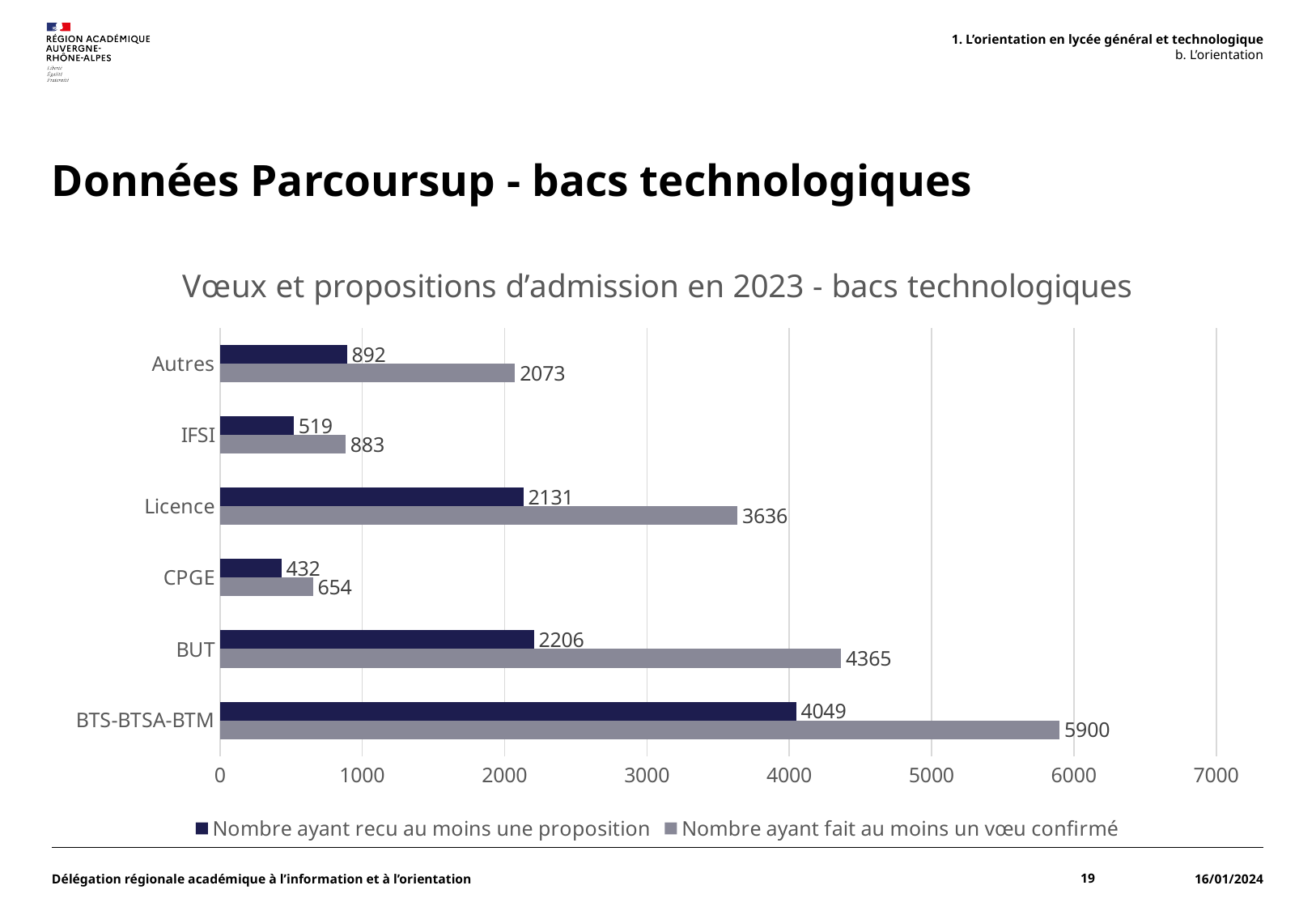
What is the value of "Nombre ayant fait au moins un vœu confirmé" for BTS-BTSA-BTM? 5900 How many series does the legend list? 2 Which is larger: "Nombre ayant fait au moins un vœu confirmé" for Autres or for IFSI? Autres What is the value of "Nombre ayant recu au moins une proposition" for Licence? 2131 Which category has the lowest value for "Nombre ayant fait au moins un vœu confirmé"? CPGE What kind of chart is shown on the slide? Bar chart Which category has the highest value for "Nombre ayant recu au moins une proposition"? BTS-BTSA-BTM What is the title of the chart? Vœux et propositions d'admission en 2023 - bacs technologiques Is the value of "Nombre ayant fait au moins un vœu confirmé" for Licence greater or less than 3000? greater What is the value of "Nombre ayant fait au moins un vœu confirmé" for CPGE? 654 How many categories are shown on the chart? 6 What is the difference between "Nombre ayant fait au moins un vœu confirmé" and "Nombre ayant recu au moins une proposition" for BUT? 2159